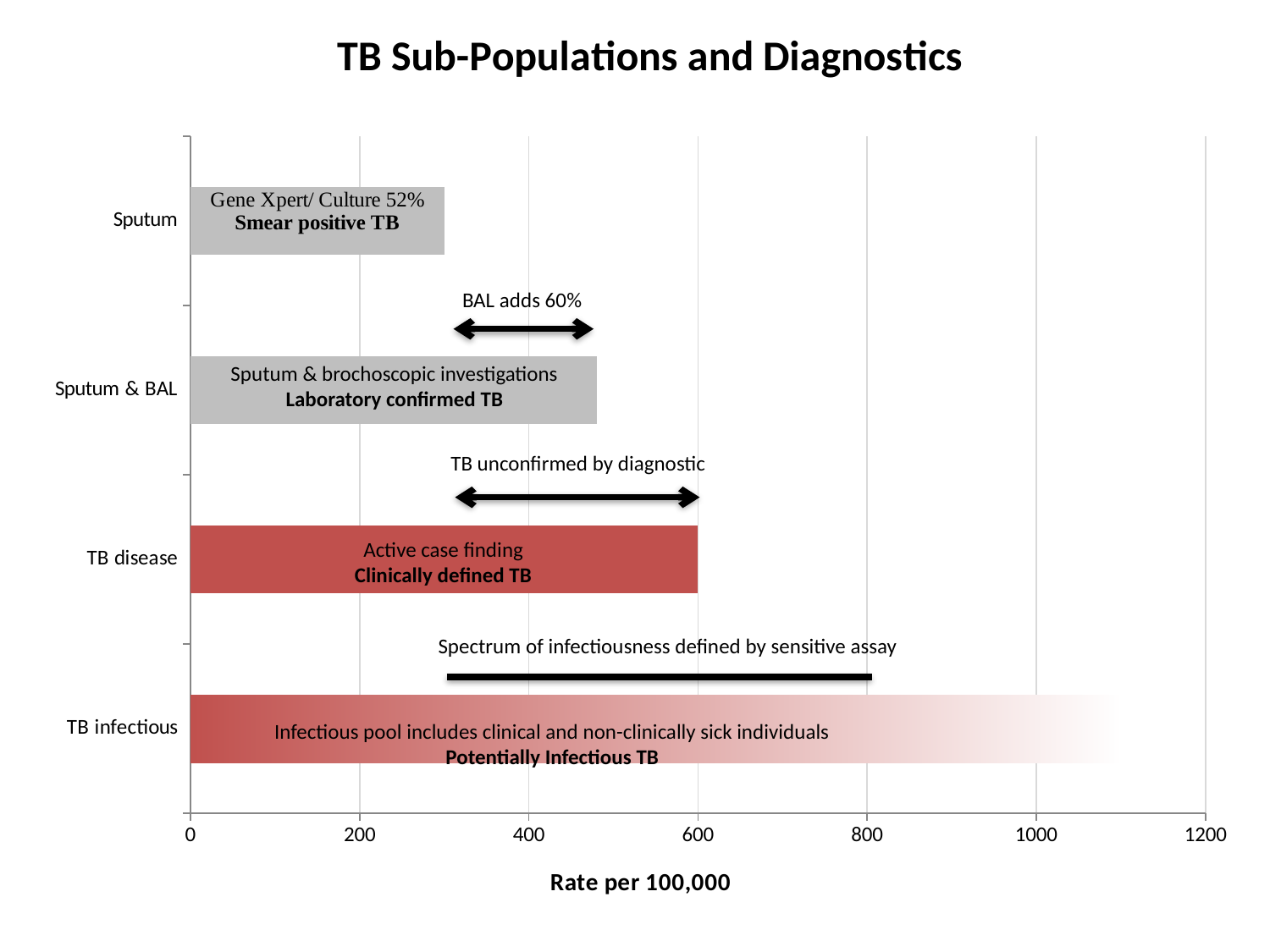
Is the value for Sputum & BAL greater or less than 400? greater Is the value for Sputum & BAL greater or less than 600? less Which is larger, the value for TB disease or the value for Sputum & BAL? TB disease What type of chart is shown on the slide? bar chart How many categories are plotted on the chart? 4 What is the value for TB disease? 600 What is the title of the x axis? Rate per 100,000 Which category has the longest bar? TB infectious Is the value for TB infectious greater or less than 800? greater Which category has the shortest bar? Sputum